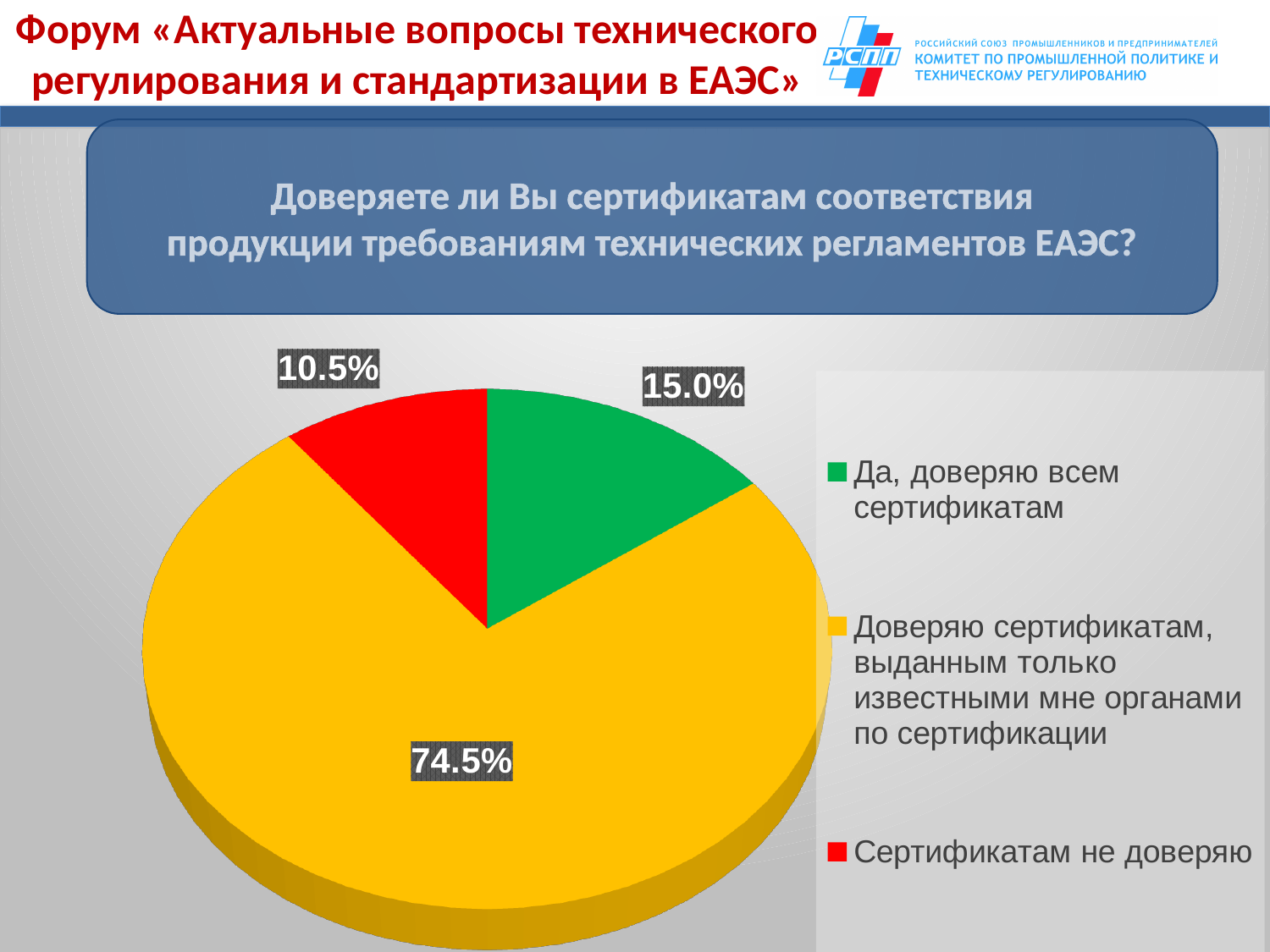
What colour is the slice for "Сертификатам не доверяю"? Red Which answer option has the largest share of the pie? Доверяю сертификатам, выданным только известными мне органами по сертификации What type of chart is shown on the slide? Pie chart What share of respondents answered "Да, доверяю всем сертификатам"? 15.0% What share of respondents answered "Сертификатам не доверяю"? 10.5% Which is larger: the share for "Да, доверяю всем сертификатам" or the share for "Сертификатам не доверяю"? Да, доверяю всем сертификатам What is the difference in percentage points between "Да, доверяю всем сертификатам" and "Сертификатам не доверяю"? 4.5 What question does the chart present responses to? Доверяете ли Вы сертификатам соответствия продукции требованиям технических регламентов ЕАЭС? Which answer option has the smallest share of the pie? Сертификатам не доверяю How many slices does the pie chart have? 3 What share of respondents answered "Доверяю сертификатам, выданным только известными мне органами по сертификации"? 74.5% What is the difference in percentage points between the largest slice and the "Да, доверяю всем сертификатам" slice? 59.5